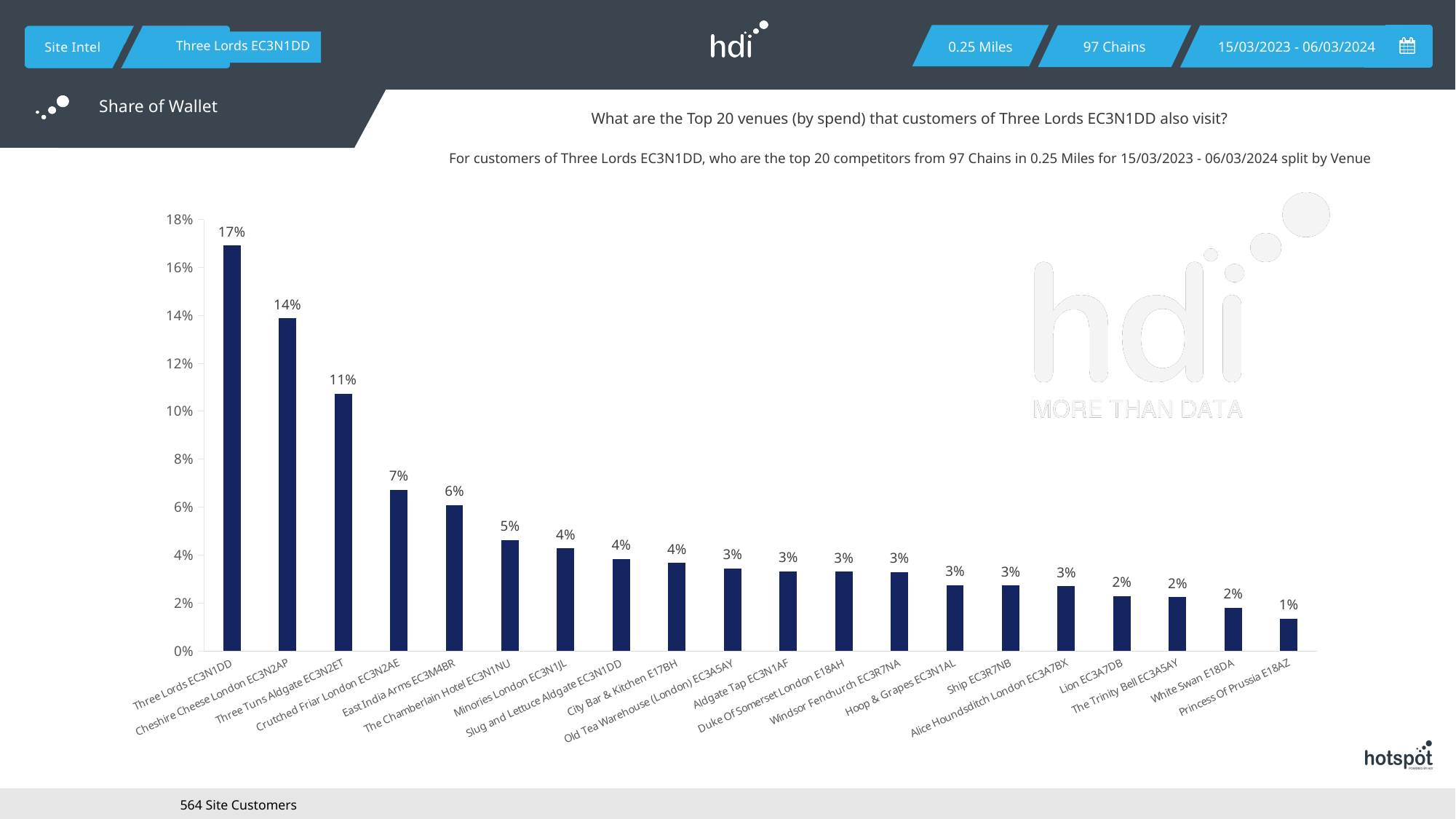
What kind of chart is shown on the slide? bar chart Which venue has the lowest value? Princess Of Prussia E18AZ Is the value for Three Tuns Aldgate EC3N2ET greater or less than 10%? greater What is the value for Three Lords EC3N1DD? 17% How many venues are shown on the chart? 20 What is the value for The Chamberlain Hotel EC3N1NU? 5% Do the values rise or fall from left to right along the x axis? fall What is the value for Crutched Friar London EC3N2AE? 7% Which is larger, the value for Three Tuns Aldgate EC3N2ET or East India Arms EC3M4BR? Three Tuns Aldgate EC3N2ET What is the value for Cheshire Cheese London EC3N2AP? 14% Which venue has the highest value? Three Lords EC3N1DD What is the difference between the values for Three Lords EC3N1DD and Cheshire Cheese London EC3N2AP? 3%